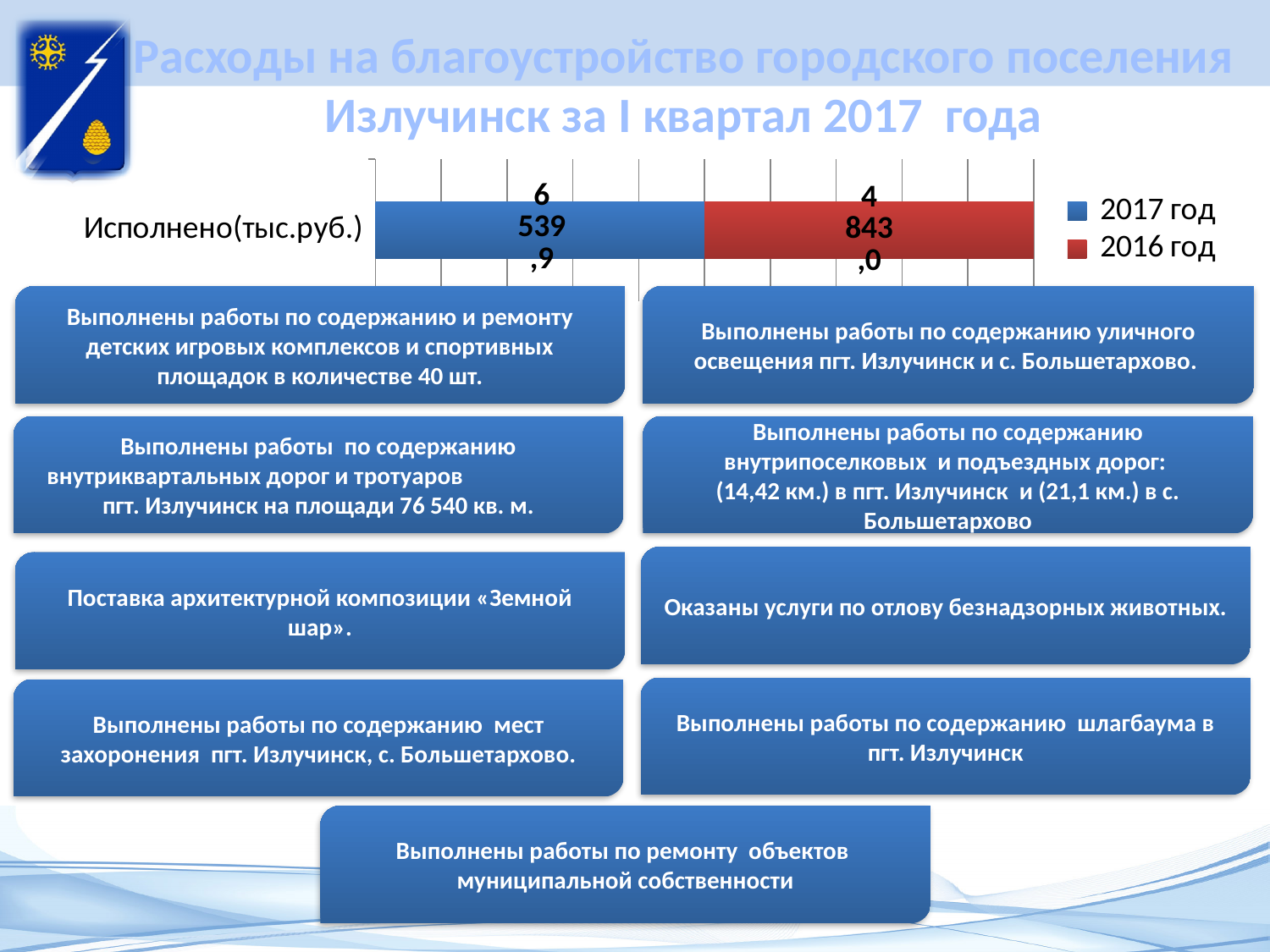
What is the difference between the 2017 год and 2016 год values? 1 696,9 What is the value for 2017 год in the chart? 6 539,9 What is the total of the stacked bar for Исполнено(тыс.руб.)? 11 382,9 How many categories are plotted on the chart? 1 What kind of chart is shown on the slide? Bar chart What is the value for 2016 год in the chart? 4 843,0 What colour represents 2016 год in the chart? Red How many series does the legend list? 2 Which series has the lowest value in the chart? 2016 год Which series has the highest value in the chart? 2017 год Which series has the larger value, 2017 год or 2016 год? 2017 год What is the category label on the chart's axis? Исполнено(тыс.руб.)